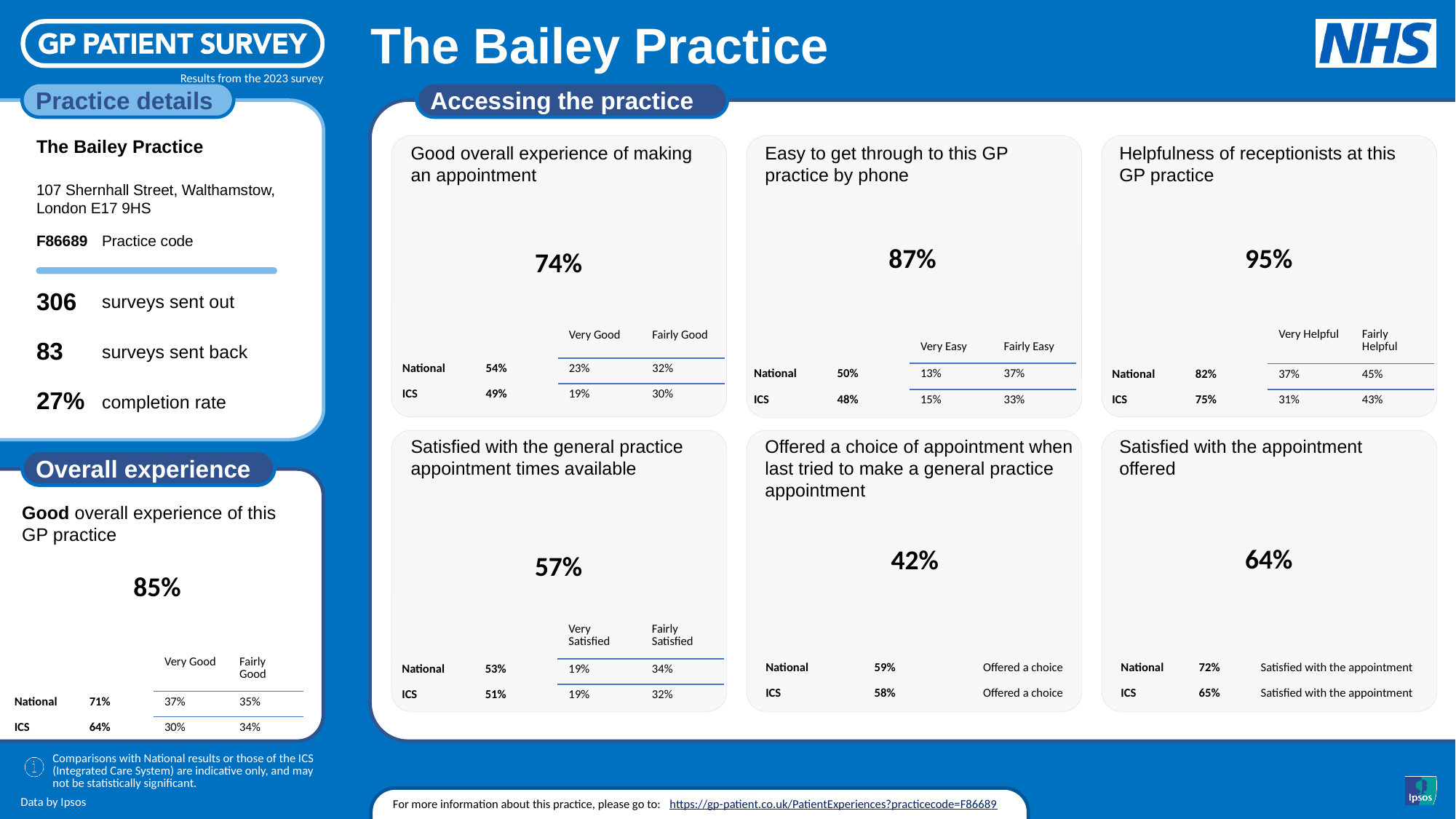
In the 'Satisfied with the general practice appointment times available' panel, what is the National 'Very Satisfied' value? 19% Which of the six 'Accessing the practice' panels shows the highest headline percentage for the practice? Helpfulness of receptionists at this GP practice Which of the six 'Accessing the practice' panels shows the lowest headline percentage for the practice? Offered a choice of appointment when last tried to make a general practice appointment In the 'Easy to get through to this GP practice by phone' panel, what is the practice's headline percentage? 87% In the 'Easy to get through to this GP practice by phone' panel, what is the difference between the practice's headline percentage and the National value? 37% In the 'Good overall experience of this GP practice' panel, what is the difference between the National and ICS values? 7% In the 'Helpfulness of receptionists at this GP practice' panel, what is the National value? 82% In the 'Good overall experience of this GP practice' panel, what is the practice's headline percentage? 85% How many panels are shown under the 'Accessing the practice' heading? 6 In the 'Offered a choice of appointment when last tried to make a general practice appointment' panel, what is the ICS value? 58% In the 'Good overall experience of making an appointment' panel, what is the ICS 'Fairly Good' value? 30% In the 'Satisfied with the appointment offered' panel, is the practice's headline percentage or the National value larger? National